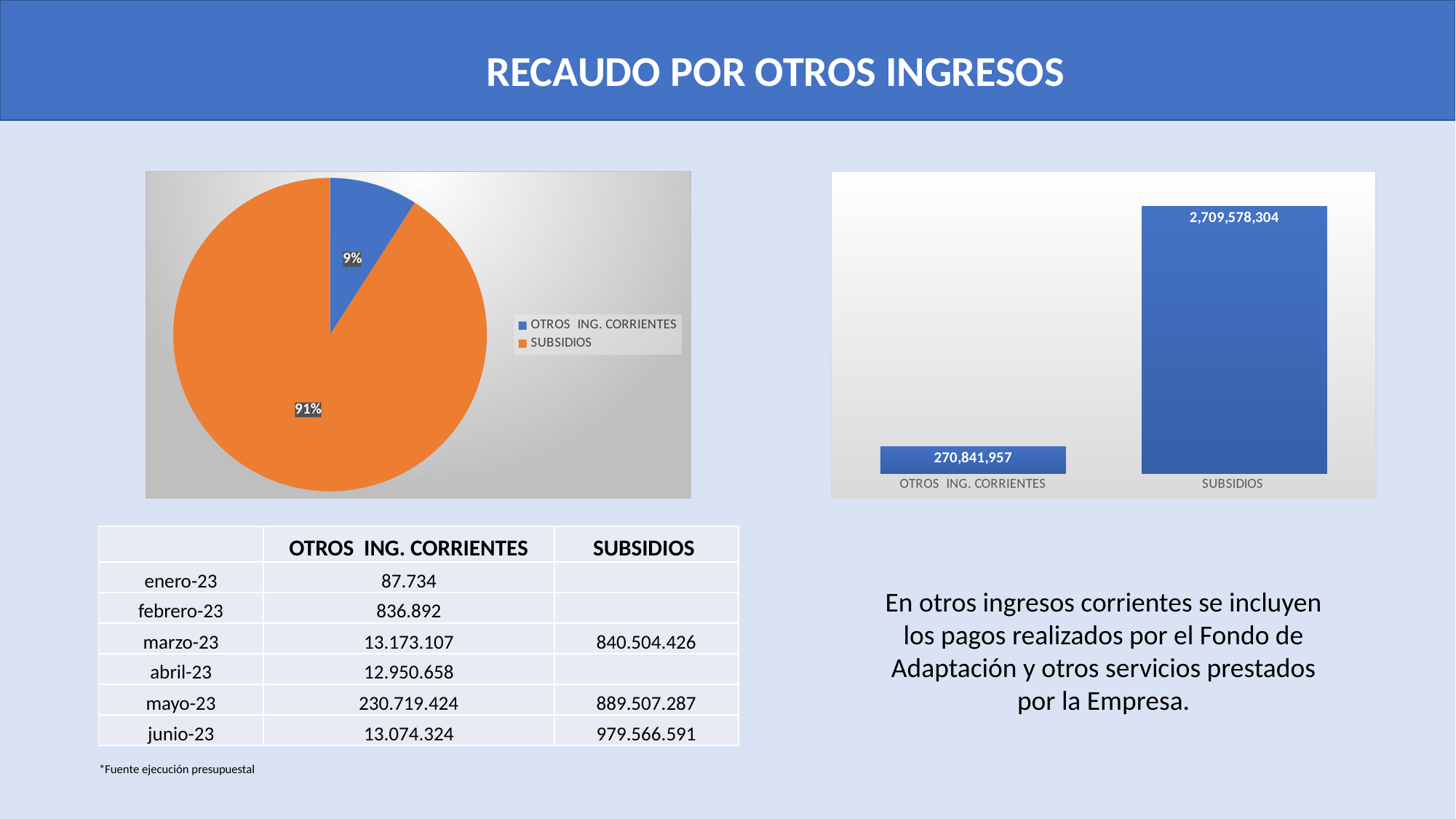
In the bar chart on the right, which is larger, SUBSIDIOS or OTROS ING. CORRIENTES? SUBSIDIOS In the bar chart on the right, which category has the lowest value? OTROS ING. CORRIENTES What kind of chart is the chart on the right? bar chart In the bar chart on the right, what is the value for SUBSIDIOS? 2,709,578,304 In the pie chart on the left, what share does OTROS ING. CORRIENTES have? 9% What kind of chart is the chart on the left? pie chart In the pie chart on the left, what colour is the SUBSIDIOS slice? orange In the pie chart on the left, which slice is the largest? SUBSIDIOS In the bar chart on the right, what is the difference between SUBSIDIOS and OTROS ING. CORRIENTES? 2,438,736,347 In the pie chart on the left, what share does SUBSIDIOS have? 91% In the bar chart on the right, what is the value for OTROS ING. CORRIENTES? 270,841,957 In the pie chart on the left, how many slices are there? 2